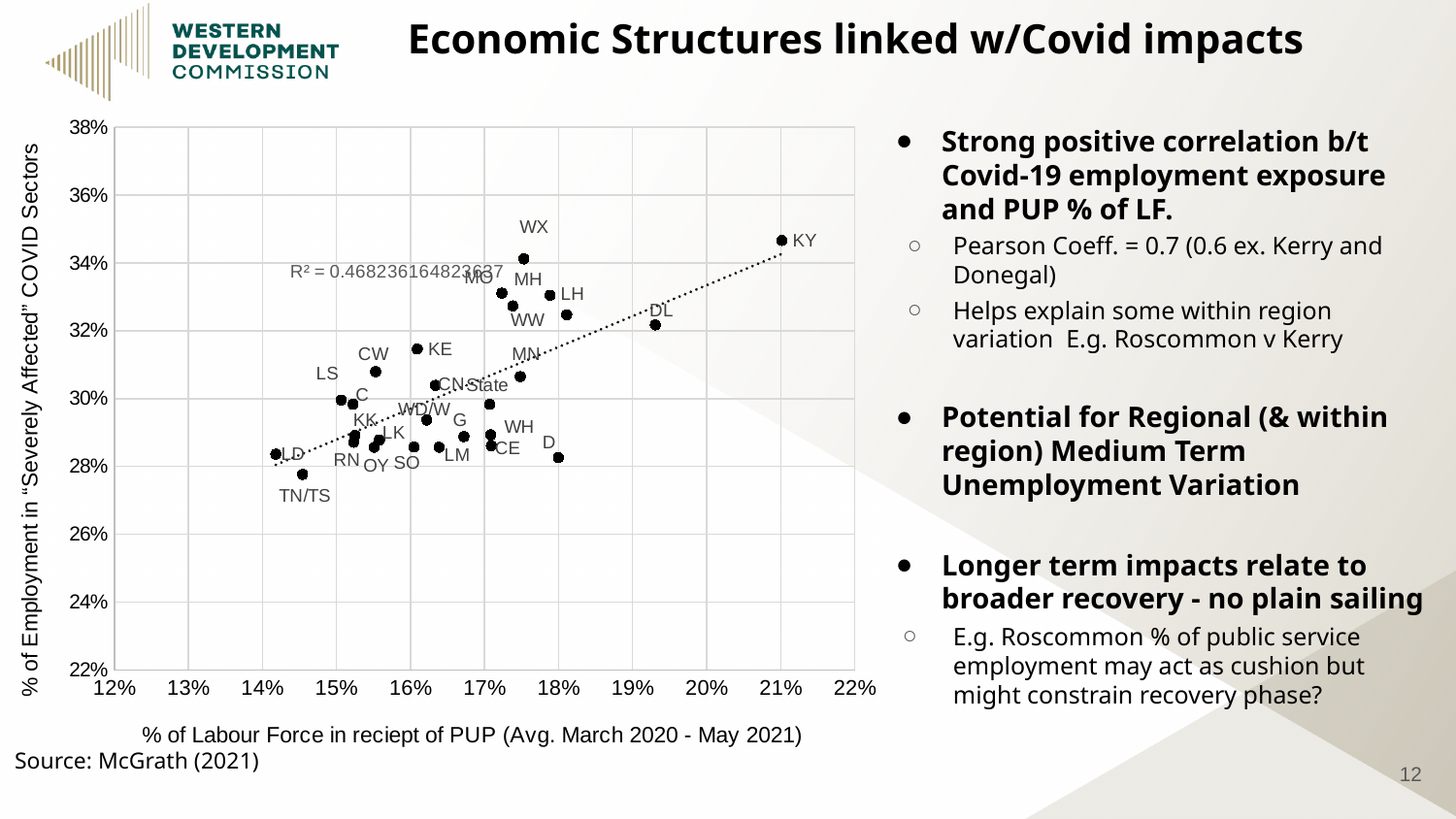
Is the % of Employment in "Severely Affected" COVID Sectors for D greater or less than 30%? less Does the trend line show the y-axis values rising or falling as the % of Labour Force in receipt of PUP increases? rising Is the % of Labour Force in receipt of PUP for KY greater or less than 20%? greater Is the % of Employment in "Severely Affected" COVID Sectors for TN/TS greater or less than 28%? less What kind of chart is shown on the slide? scatter chart Which labelled point has the lowest % of Labour Force in receipt of PUP (x axis)? LD Which has a higher % of Employment in "Severely Affected" COVID Sectors, DL or D? DL Which labelled point has the highest % of Labour Force in receipt of PUP (x axis)? KY What is the title of the x axis of the chart? % of Labour Force in reciept of PUP (Avg. March 2020 - May 2021) Which labelled point has the lowest % of Employment in "Severely Affected" COVID Sectors (y axis)? TN/TS